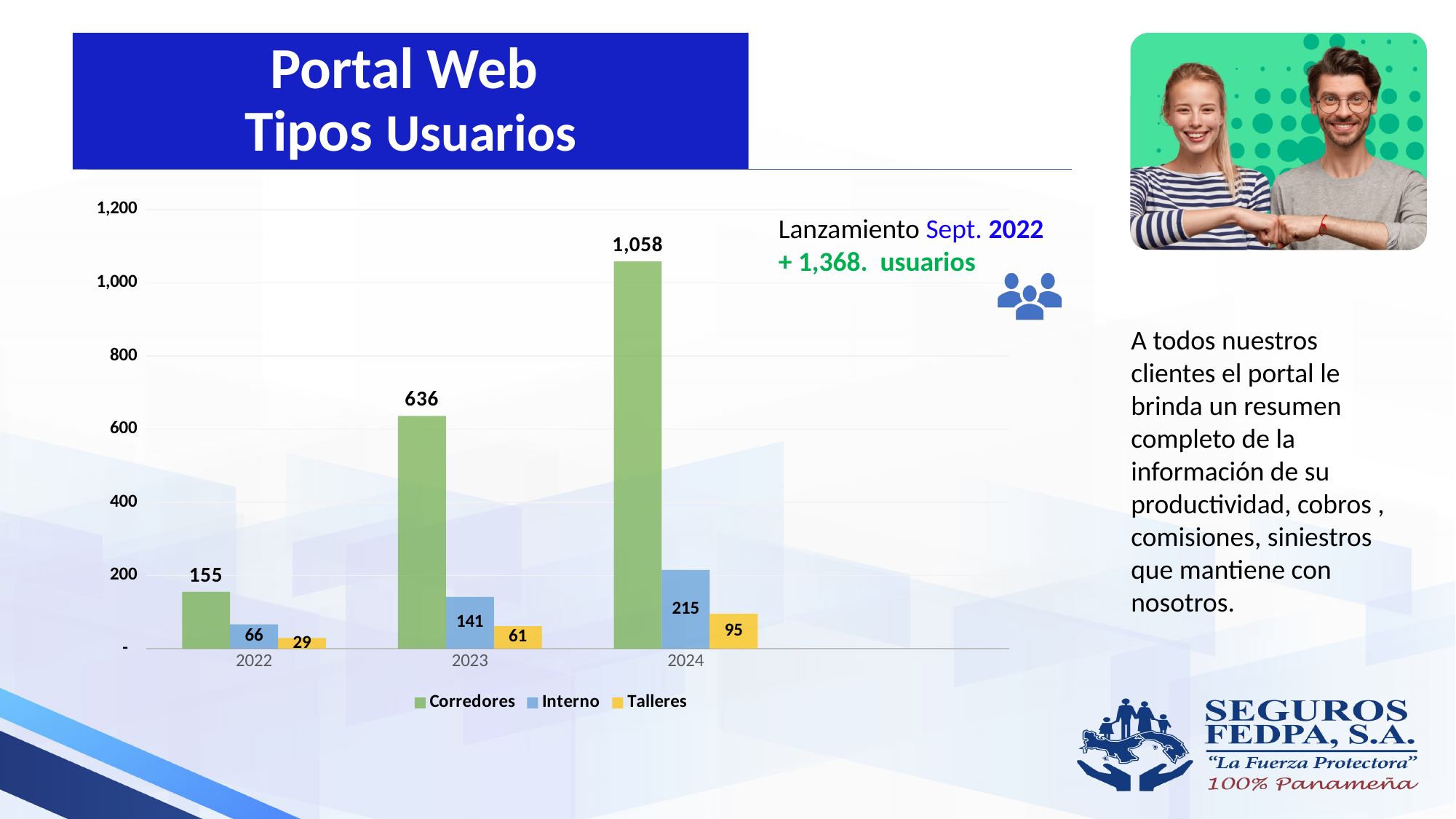
What is the value for Interno in 2023? 141 Is the value for Corredores in 2023 greater or less than 600? greater What is the difference between the Corredores values for 2024 and 2023? 422 Do the Interno values rise or fall from 2022 to 2024? rise What is the value for Corredores in 2024? 1,058 Which year has the highest value for Corredores? 2024 What is the value for Talleres in 2022? 29 Which year has the lowest value for Talleres? 2022 How many years are shown on the x axis? 3 What kind of chart is shown on the slide? bar chart Which is larger: Interno in 2024 or Talleres in 2024? Interno in 2024 How many series does the legend list? 3